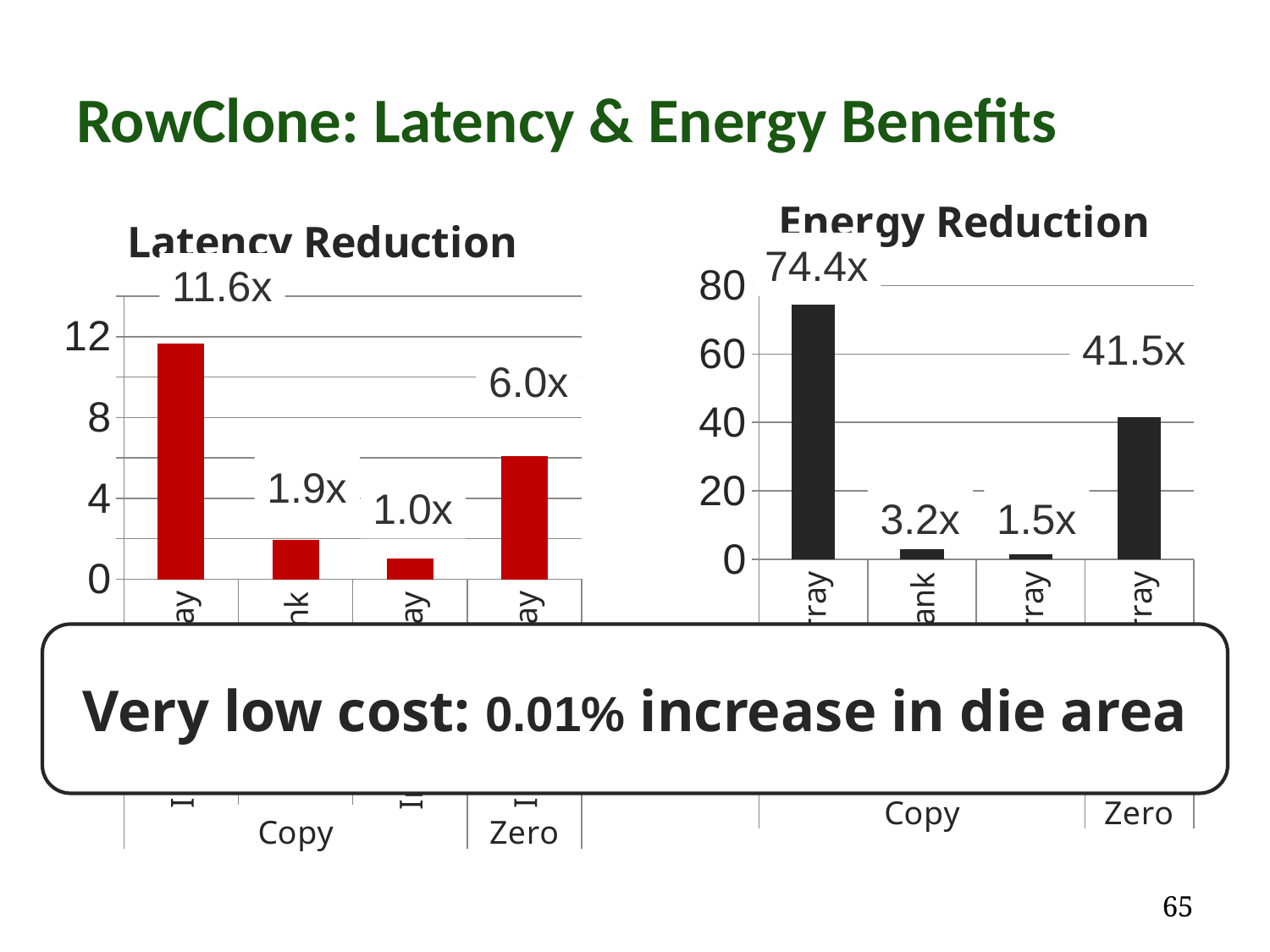
What kind of chart is the Latency Reduction chart? bar chart In the Latency Reduction chart, what is the lowest value shown? 1.0x In the Latency Reduction chart, how many bars are plotted? 4 In the Energy Reduction chart, what is the lowest value shown? 1.5x In the Energy Reduction chart, what is the difference between the highest bar (74.4x) and the Zero bar (41.5x)? 32.9x In the Latency Reduction chart, what is the value of the bar in the Zero group? 6.0x In the Energy Reduction chart, what is the highest value shown? 74.4x In the Latency Reduction chart, what is the value of the first (leftmost) bar? 11.6x In the Energy Reduction chart, how many bars are plotted? 4 In the Latency Reduction chart, what is the difference between the first bar (11.6x) and the Zero bar (6.0x)? 5.6x In the Energy Reduction chart, is the value of the first (leftmost) bar greater or less than 60? greater In the Energy Reduction chart, what is the value of the bar in the Zero group? 41.5x